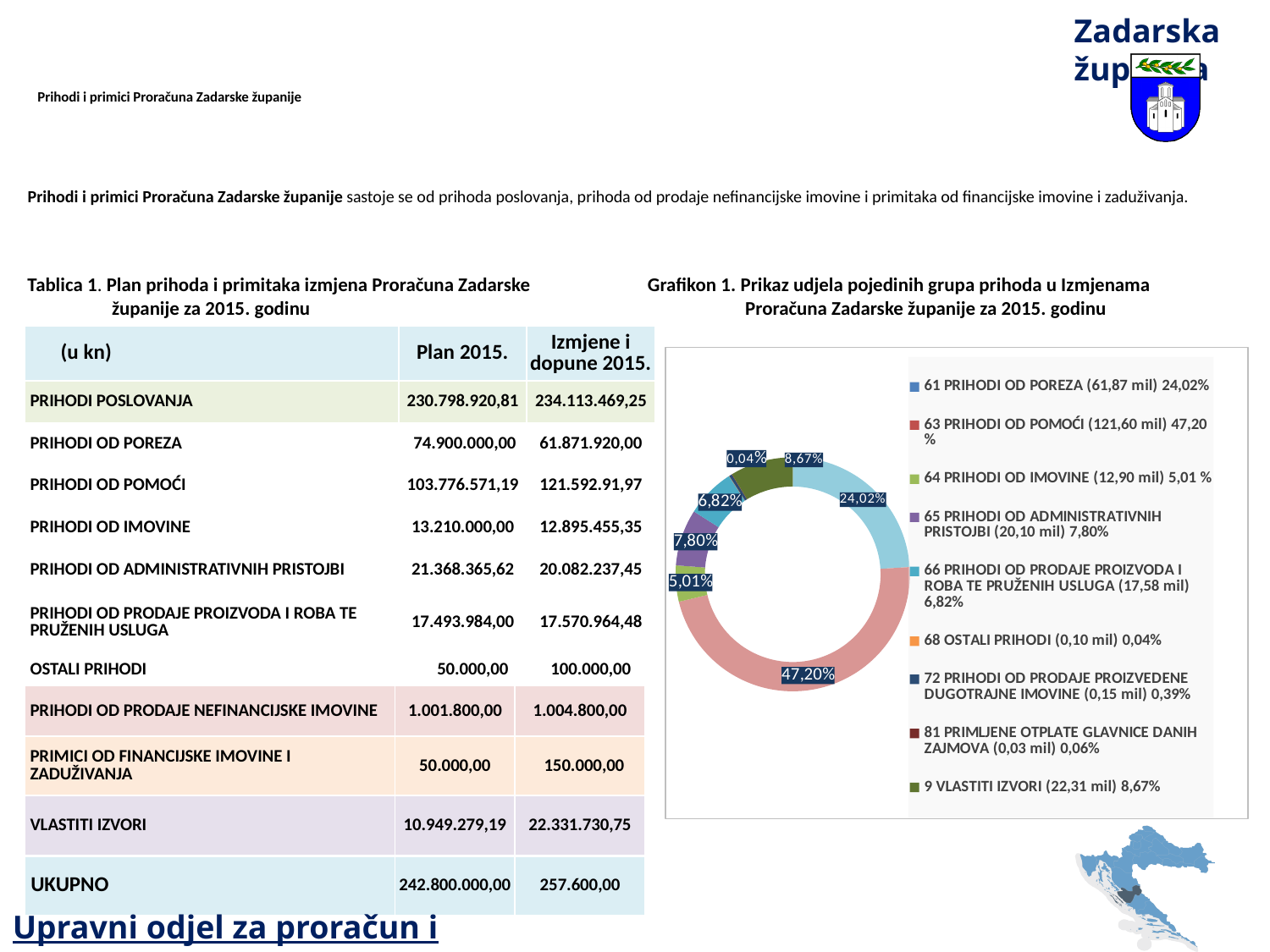
In Grafikon 1, what share is shown for 64 PRIHODI OD IMOVINE? 5,01% In Grafikon 1, what share is shown for 61 PRIHODI OD POREZA? 24,02% In Grafikon 1, which has the larger share: 65 PRIHODI OD ADMINISTRATIVNIH PRISTOJBI or 66 PRIHODI OD PRODAJE PROIZVODA I ROBA TE PRUŽENIH USLUGA? 65 PRIHODI OD ADMINISTRATIVNIH PRISTOJBI In Grafikon 1, how many percentage points larger is the share of 63 PRIHODI OD POMOĆI than that of 61 PRIHODI OD POREZA? 23,18 percentage points What kind of chart is Grafikon 1? Doughnut (pie) chart What is the title of the chart on the slide? Grafikon 1. Prikaz udjela pojedinih grupa prihoda u Izmjenama Proračuna Zadarske županije za 2015. godinu In Grafikon 1, what share is shown for 63 PRIHODI OD POMOĆI? 47,20% How many entries does the legend of Grafikon 1 list? 9 In Grafikon 1, what share is shown for 65 PRIHODI OD ADMINISTRATIVNIH PRISTOJBI? 7,80% In Grafikon 1, which group of revenues has the largest share? 63 PRIHODI OD POMOĆI In Grafikon 1, what share is shown for 9 VLASTITI IZVORI? 8,67% In Grafikon 1, which group of revenues has the smallest share? 68 OSTALI PRIHODI